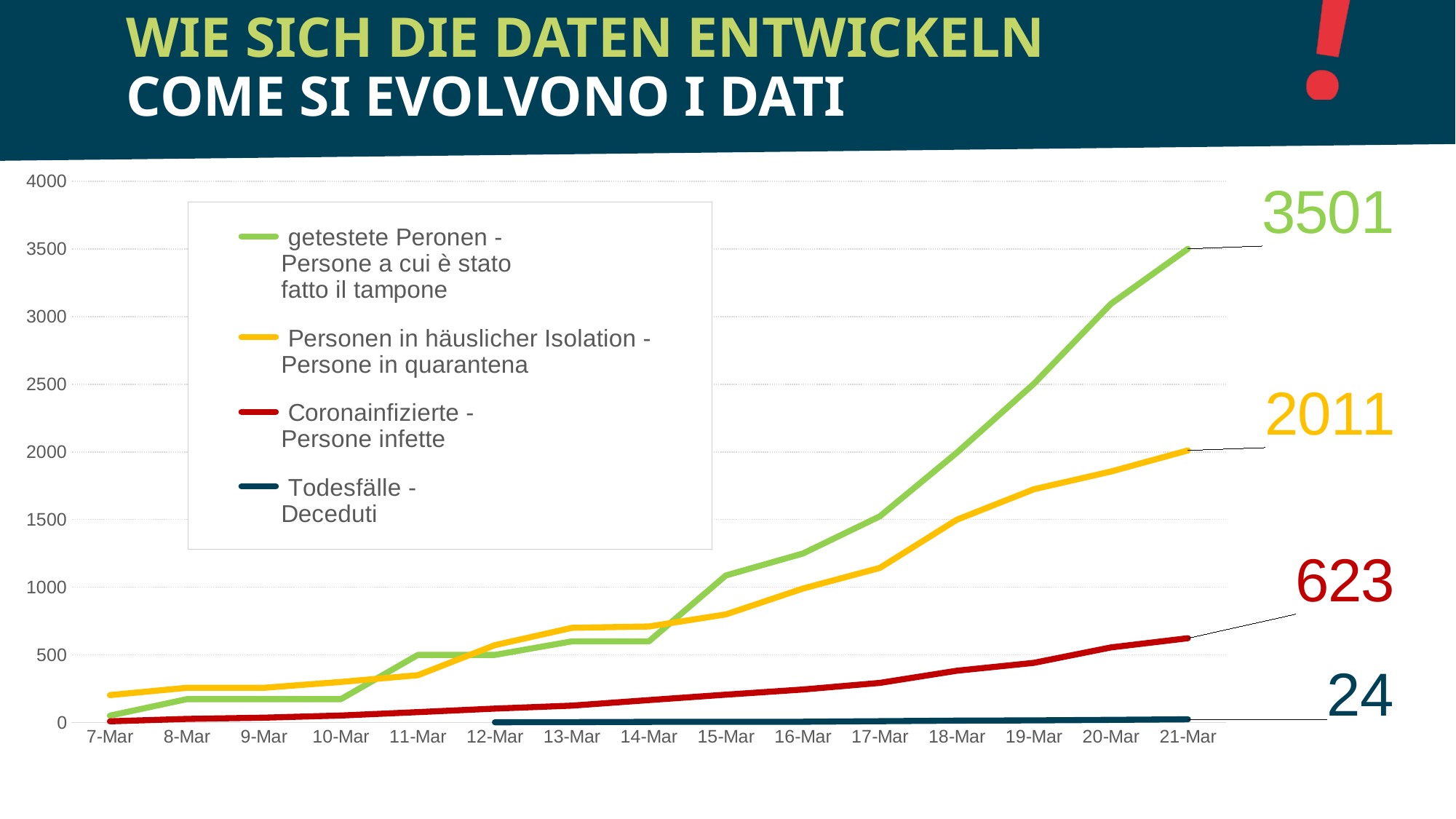
What is the difference between the 21-Mar values for Coronainfizierte and Todesfälle? 599 Which series has the highest value on 21-Mar? getestete Peronen - Persone a cui è stato fatto il tampone Is the value for Personen in häuslicher Isolation on 7-Mar greater or less than 500? less What is the difference between the 21-Mar values for getestete Peronen and Personen in häuslicher Isolation? 1490 How many series does the legend list? 4 Which series has the lowest value on 21-Mar? Todesfälle - Deceduti What is the value for Todesfälle - Deceduti on 21-Mar? 24 What is the value for Coronainfizierte - Persone infette on 21-Mar? 623 What kind of chart is shown on the slide? line chart How many dates are shown on the x axis? 15 What is the value for getestete Peronen - Persone a cui è stato fatto il tampone on 21-Mar? 3501 What is the value for Personen in häuslicher Isolation - Persone in quarantena on 21-Mar? 2011